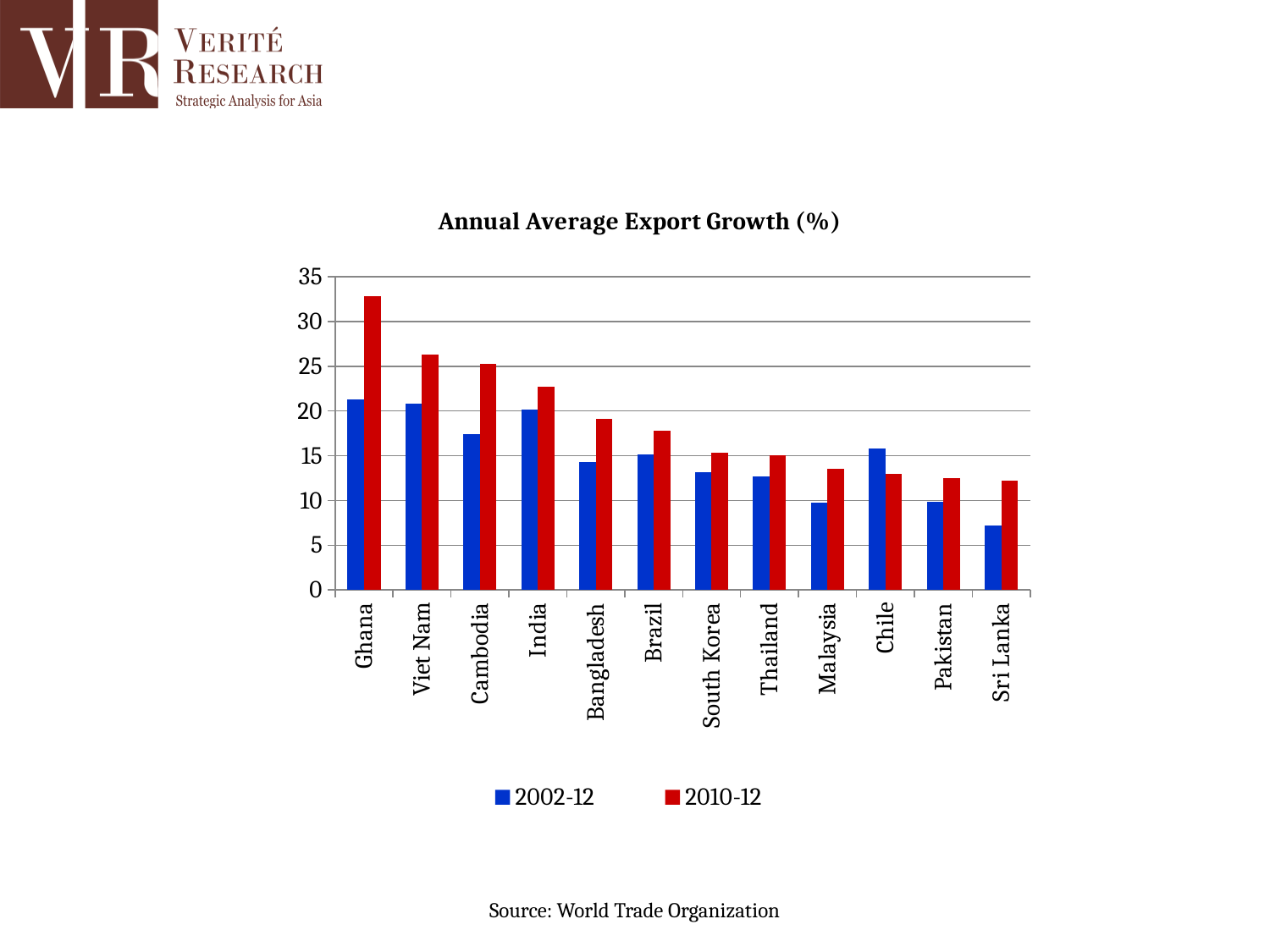
Which is larger, the 2002-12 value for Pakistan or the 2002-12 value for Sri Lanka? Pakistan For Chile, which period has the larger value, 2002-12 or 2010-12? 2002-12 Is the 2002-12 value for Sri Lanka greater or less than 10? less Which country has the lowest 2002-12 annual average export growth? Sri Lanka Is the 2010-12 value for Chile greater or less than 15? less Which country has the highest 2010-12 annual average export growth? Ghana How many countries are shown on the x axis of the chart? 12 How many series does the legend list? 2 What kind of chart is shown on the slide? Bar chart Is the 2010-12 value for Cambodia greater or less than 20? greater What is the source cited for the chart? World Trade Organization